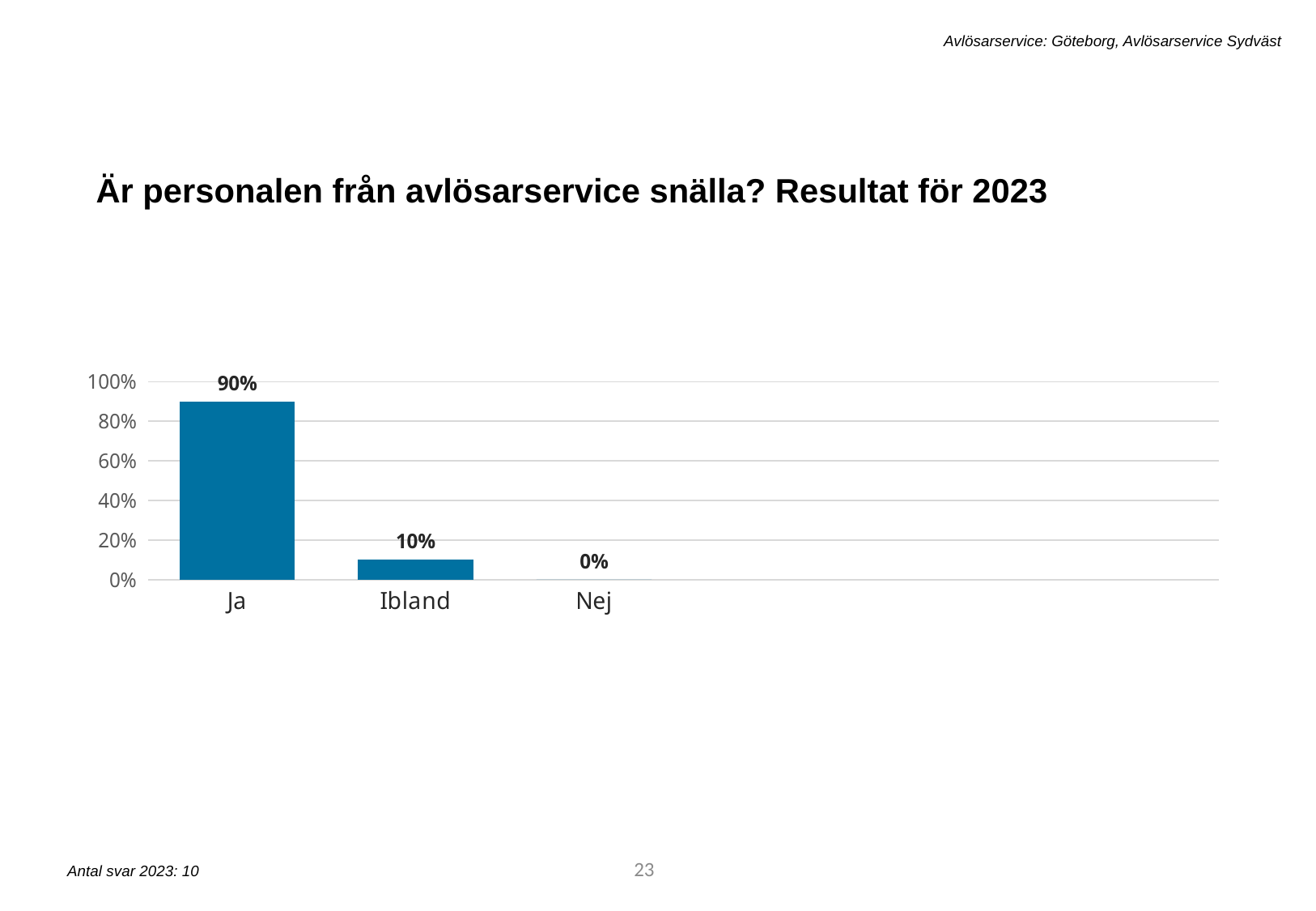
Which is larger, the value for Ibland or the value for Nej? Ibland What is the value for Ja? 90% Which category has the lowest value? Nej What kind of chart is shown on the slide? bar chart What is the value for Nej? 0% How many categories are shown on the x axis? 3 What is the value for Ibland? 10% What is the title of the chart? Är personalen från avlösarservice snälla? Resultat för 2023 What is the difference between the values for Ja and Ibland? 80% Do the values rise or fall from left to right along the x axis? fall Which category has the highest value? Ja Is the value for Ja greater or less than 80%? greater